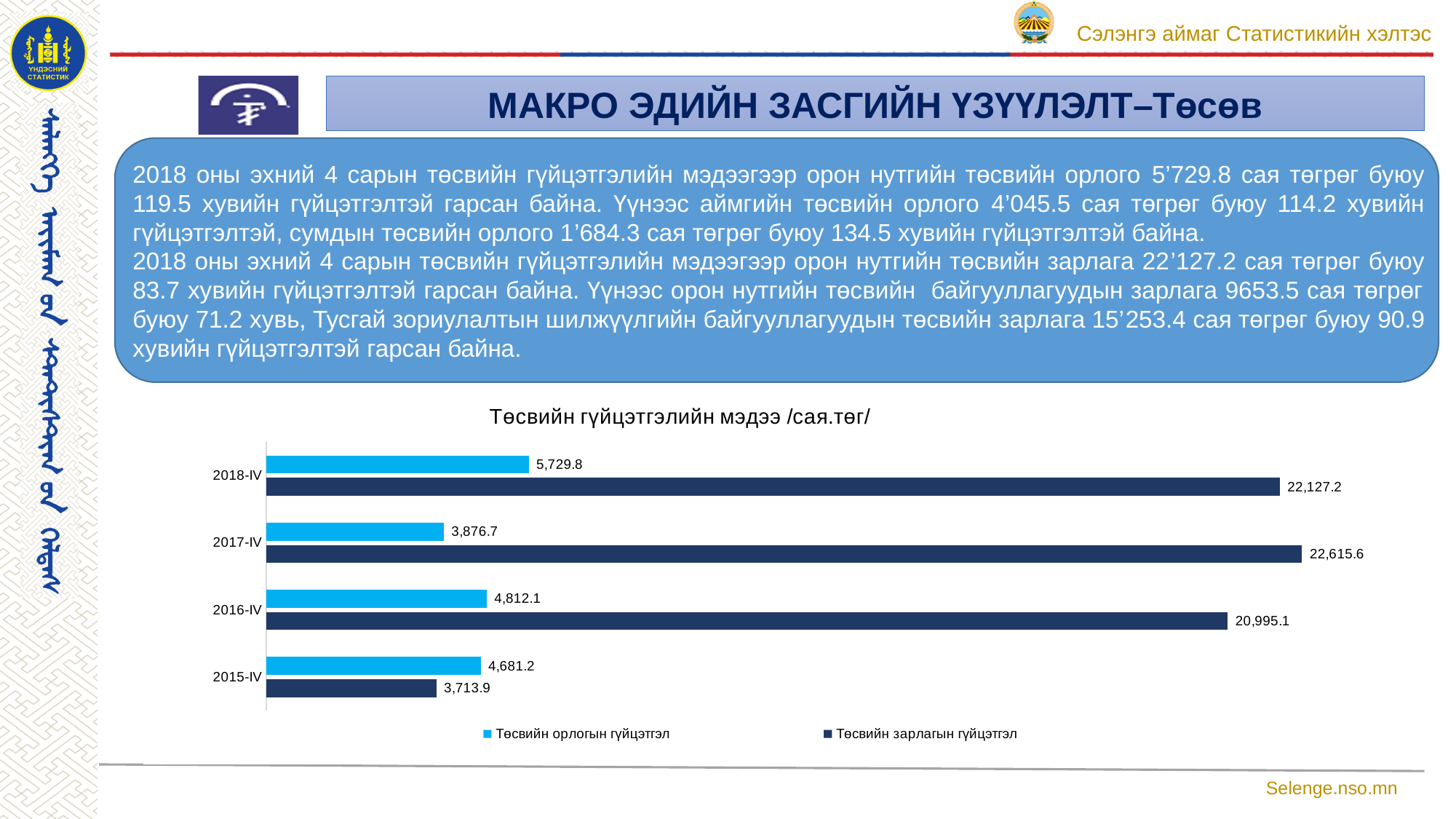
Which series is shown in dark blue in the chart? Төсвийн зарлагын гүйцэтгэл What is the value of Төсвийн орлогын гүйцэтгэл for 2018-IV? 5,729.8 For 2015-IV, which is larger: Төсвийн орлогын гүйцэтгэл or Төсвийн зарлагын гүйцэтгэл? Төсвийн орлогын гүйцэтгэл How many series does the chart legend list? 2 Which period has the lowest value for Төсвийн зарлагын гүйцэтгэл? 2015-IV What is the difference between Төсвийн зарлагын гүйцэтгэл and Төсвийн орлогын гүйцэтгэл for 2018-IV? 16,397.4 What is the value of Төсвийн зарлагын гүйцэтгэл for 2015-IV? 3,713.9 How many categories (periods) are shown on the chart? 4 Which period has the highest value for Төсвийн орлогын гүйцэтгэл? 2018-IV What is the value of Төсвийн зарлагын гүйцэтгэл for 2017-IV? 22,615.6 What is the title of the chart? Төсвийн гүйцэтгэлийн мэдээ /сая.төг/ What type of chart is shown on the slide? Bar chart